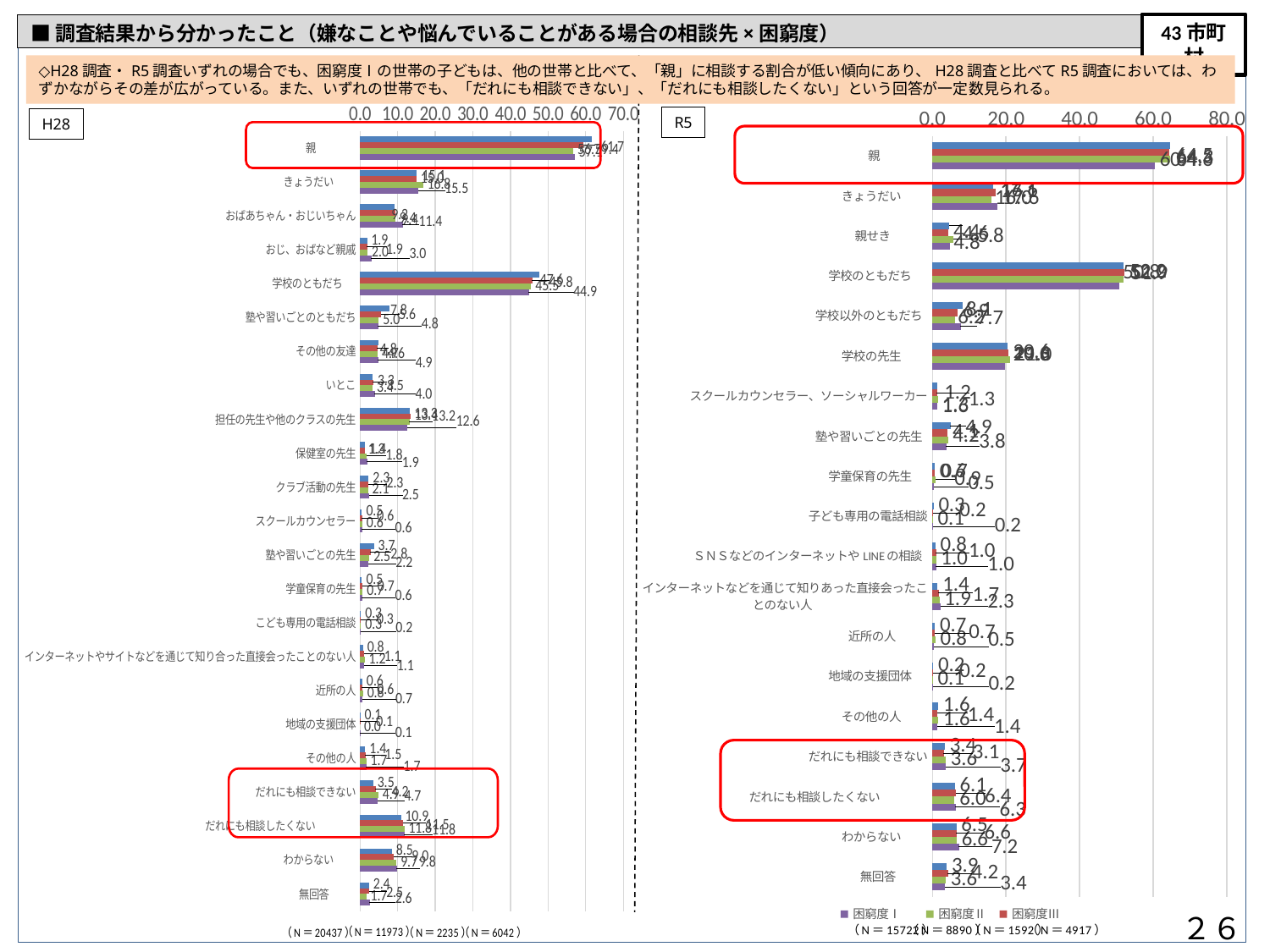
How many categories are shown in the R5 chart? 19 In the R5 chart, what is the 困窮度Ⅰ value for わからない? 7.2 In the R5 chart, which category has the highest values? 親 In the R5 chart, is the 困窮度Ⅰ value for 学校のともだち greater or less than 40.0? greater In the H28 chart, what is the 困窮度Ⅰ value for だれにも相談したくない? 11.8 In the H28 chart, which is larger for 困窮度Ⅰ: だれにも相談したくない or だれにも相談できない? だれにも相談したくない In the H28 chart, what is the 困窮度Ⅰ value for だれにも相談できない? 4.7 In the H28 chart, which category has the highest values? 親 What kind of chart is the H28 chart on the left? bar chart In the R5 chart, what is the difference between the 困窮度Ⅰ values for わからない (7.2) and だれにも相談したくない (6.3)? 0.9 In the R5 chart, what is the 困窮度Ⅰ value for だれにも相談できない? 3.7 In the H28 chart, is the 困窮度Ⅰ value for 親 greater or less than 50.0? greater